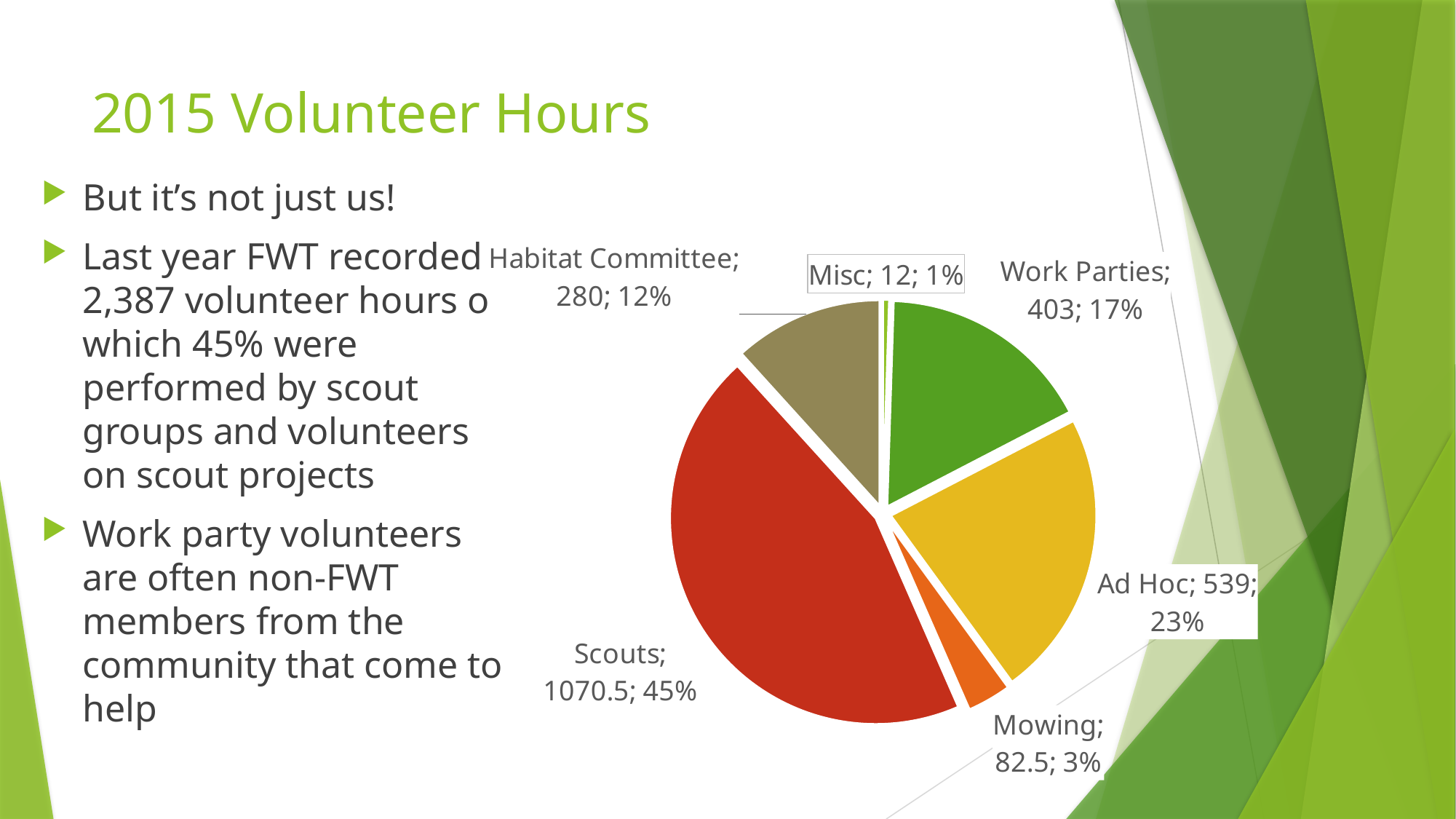
Which category has the largest slice of the pie? Scouts What percentage of the pie is Habitat Committee? 12% What is the difference in hours between Ad Hoc and Work Parties? 136 What is the title of the slide containing the pie chart? 2015 Volunteer Hours How many volunteer hours are shown for Scouts? 1070.5 How many slices does the pie chart have? 6 How many hours are shown for Mowing? 82.5 What percentage of the pie is Work Parties? 17% What kind of chart is shown on the slide? pie chart Which has more hours, Mowing or Habitat Committee? Habitat Committee How many volunteer hours are shown for Ad Hoc? 539 Which category has the smallest slice of the pie? Misc